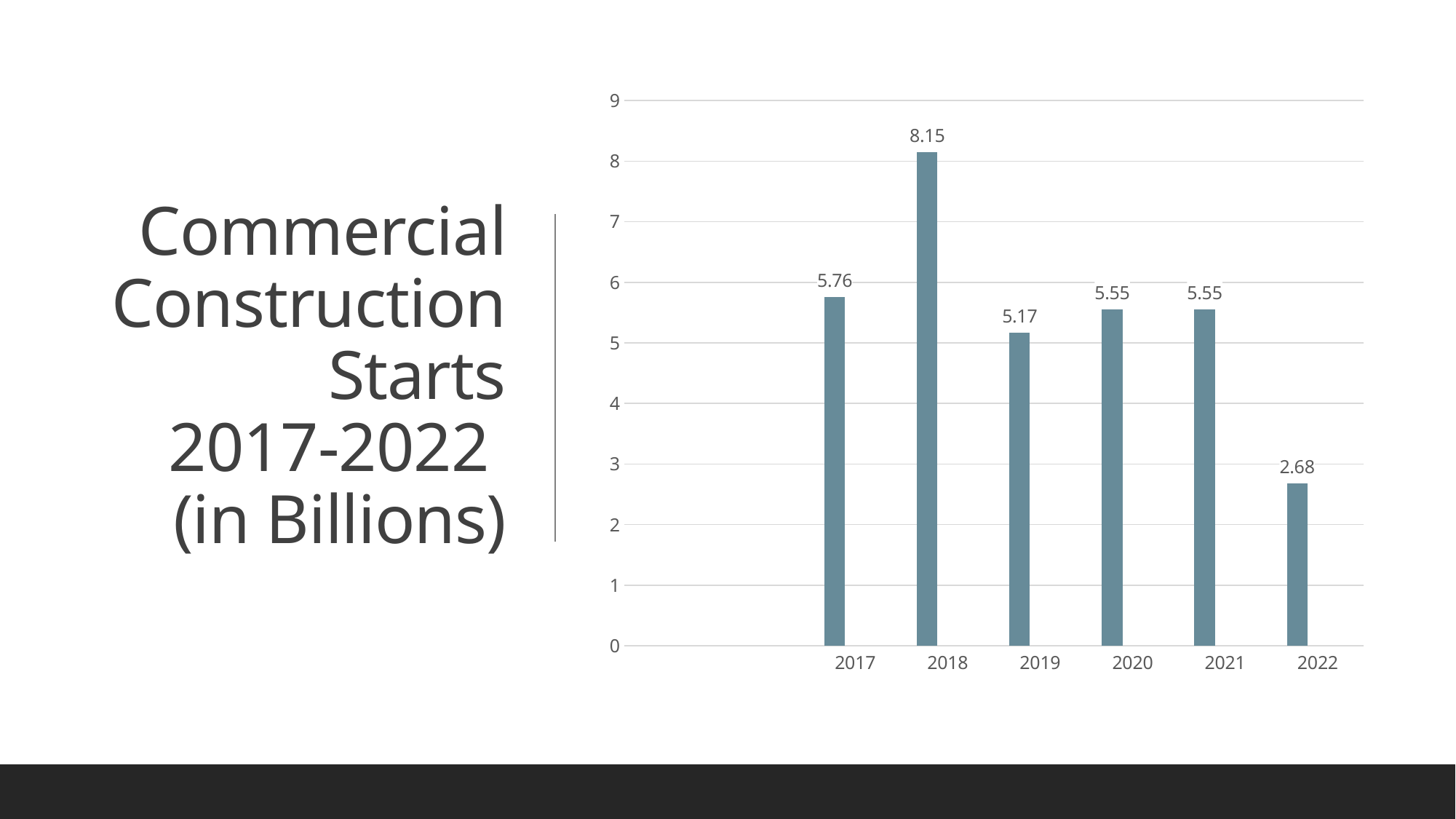
What is the value for 2017? 5.76 What is the value for 2022? 2.68 What is the difference between the values for 2017 and 2022? 3.08 Which is larger, the value for 2017 or the value for 2019? 2017 What is the value for 2018? 8.15 Which year has the highest value? 2018 Is the value for 2018 greater or less than 8? greater How many years are shown on the x axis? 6 Which year has the lowest value? 2022 What kind of chart is shown on the slide? bar chart What is the difference between the values for 2018 and 2019? 2.98 What is the title of the slide? Commercial Construction Starts 2017-2022 (in Billions)